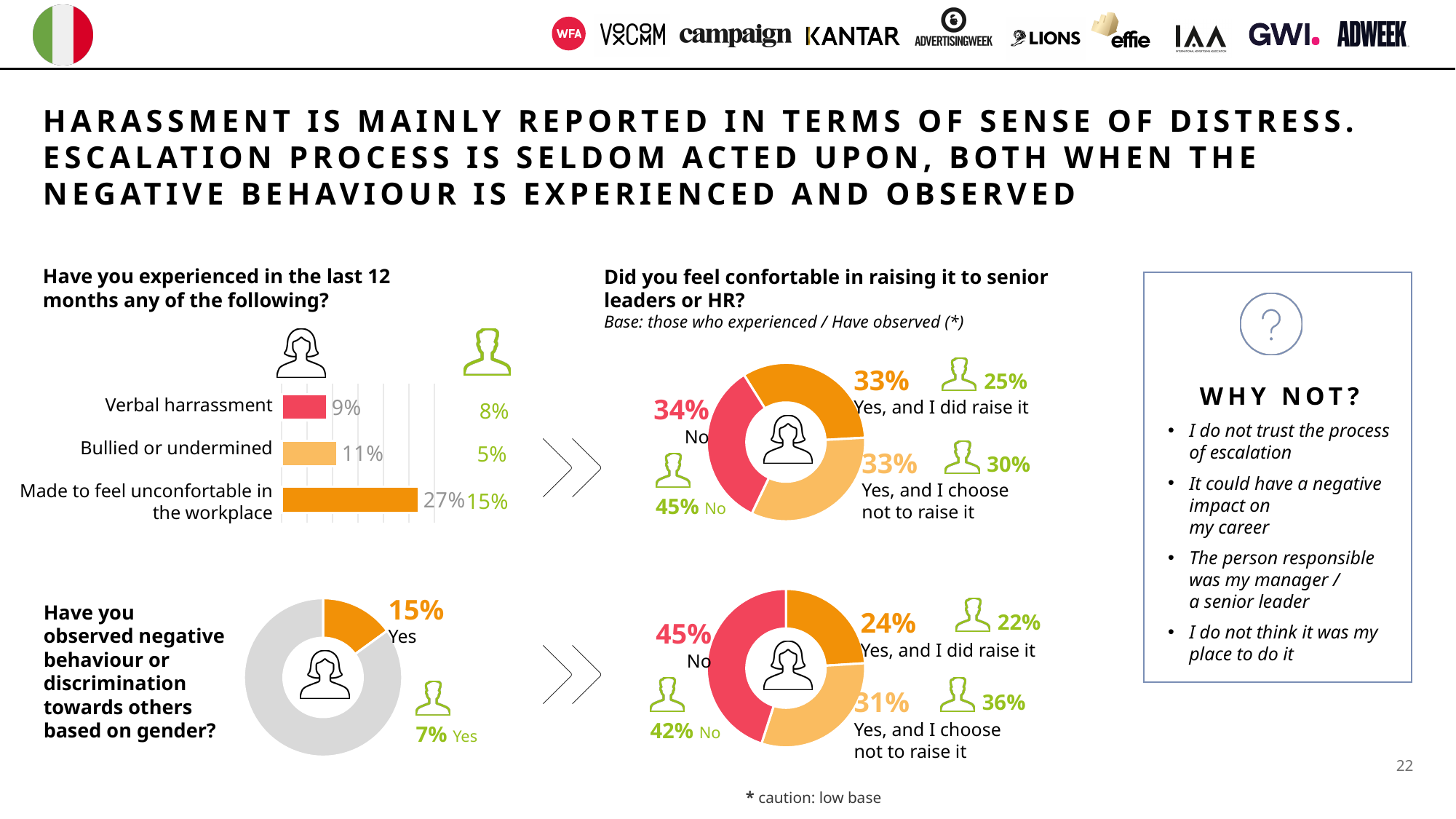
How many categories does the bar chart 'Have you experienced in the last 12 months any of the following?' show? 3 In the bar chart 'Have you experienced in the last 12 months any of the following?', which category has the lowest value? Verbal harrassment In the bar chart 'Have you experienced in the last 12 months any of the following?', what is the value for 'Made to feel unconfortable in the workplace'? 27% In the top donut chart 'Did you feel confortable in raising it to senior leaders or HR?', what share is 'Yes, and I did raise it'? 33% What kind of chart is used for 'Have you experienced in the last 12 months any of the following?'? bar chart In the bottom-right donut chart (raising observed behaviour to senior leaders or HR), what share is 'No'? 45% In the bar chart 'Have you experienced in the last 12 months any of the following?', what is the difference between 'Made to feel unconfortable in the workplace' and 'Verbal harrassment'? 18% In the top donut chart 'Did you feel confortable in raising it to senior leaders or HR?', what share is 'No'? 34% In the bottom-right donut chart (raising observed behaviour to senior leaders or HR), which is larger: 'Yes, and I did raise it' or 'Yes, and I choose not to raise it'? Yes, and I choose not to raise it In the bar chart 'Have you experienced in the last 12 months any of the following?', which category has the highest value? Made to feel unconfortable in the workplace In the bar chart 'Have you experienced in the last 12 months any of the following?', what is the value for 'Bullied or undermined'? 11%